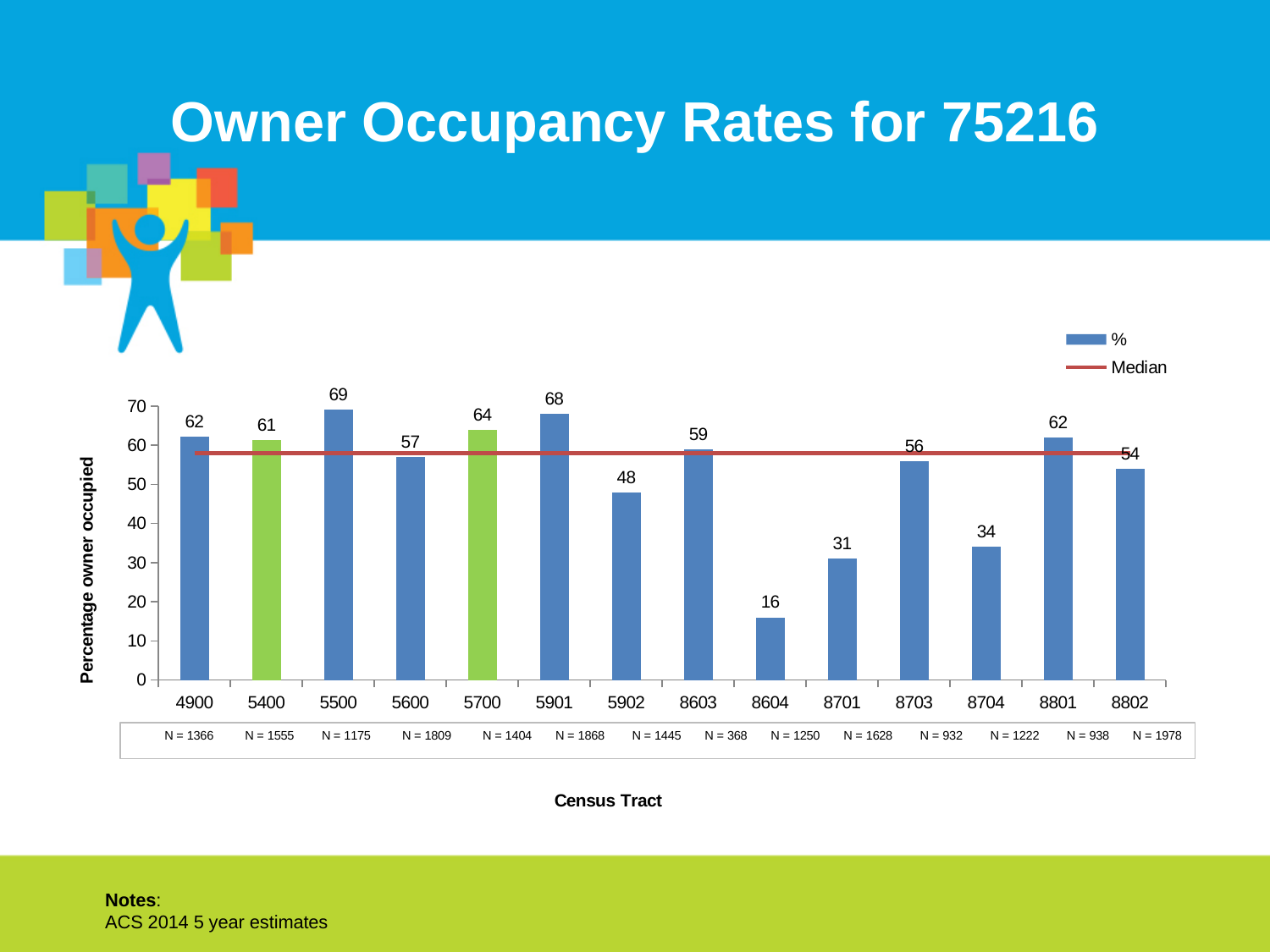
What is the difference between the owner occupancy rates for census tracts 5901 and 8701? 37 What is the label of the y axis? Percentage owner occupied What is the owner occupancy rate for census tract 5902? 48 Which census tract has the lowest owner occupancy rate? 8604 Which census tract has a higher owner occupancy rate, 5700 or 8703? 5700 What is the title of the chart? Owner Occupancy Rates for 75216 What is the owner occupancy rate for census tract 5500? 69 How many census tracts are shown on the x axis? 14 Which census tract has the highest owner occupancy rate? 5500 What is the owner occupancy rate for census tract 8604? 16 How many entries does the legend list? 2 What kind of chart is shown on the slide? Bar chart